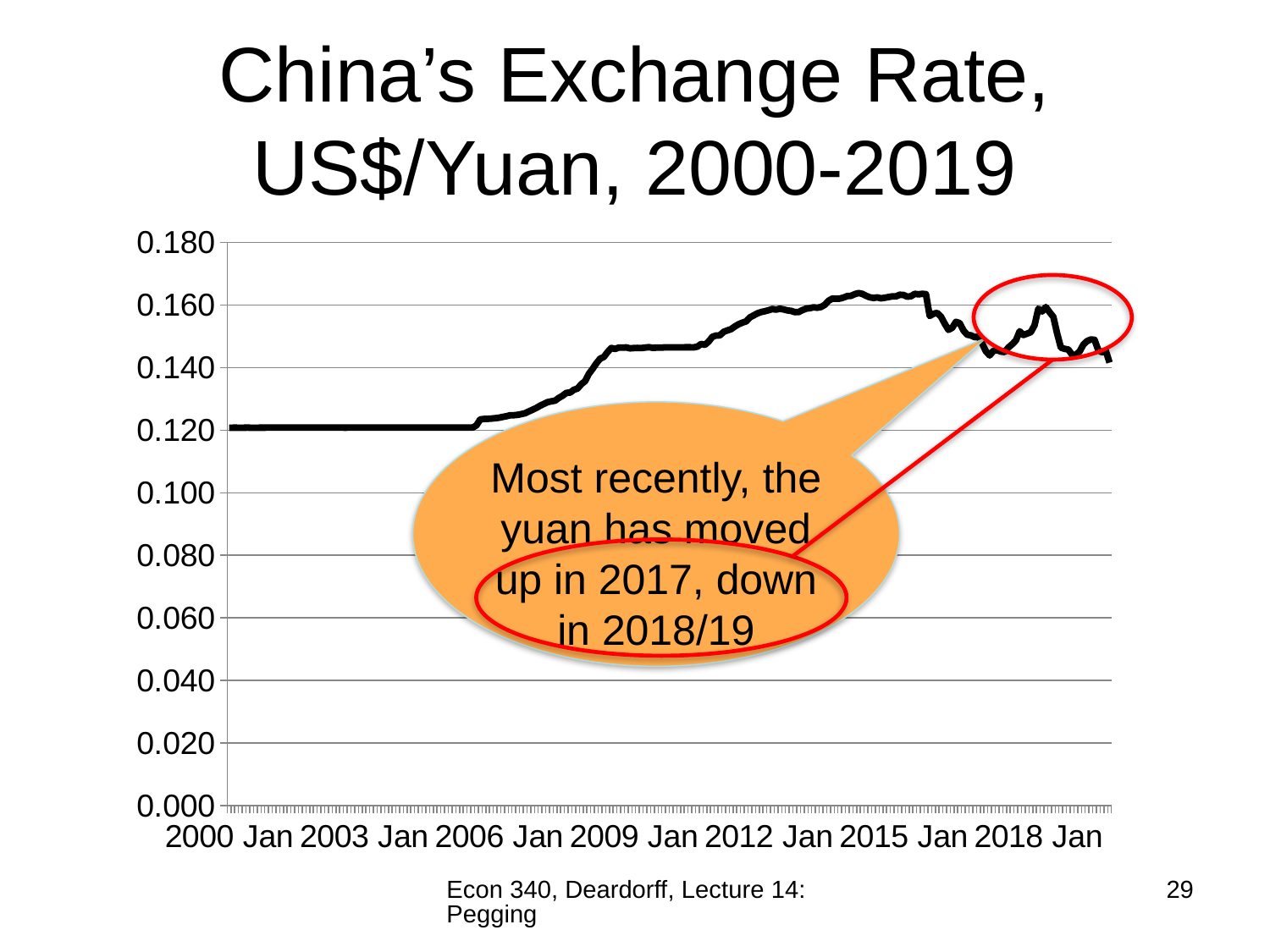
Is the exchange rate in 2006 Jan greater or less than 0.140? less What is the highest value shown on the y axis? 0.180 Is the exchange rate in 2009 Jan greater or less than 0.120? greater What kind of chart is shown on the slide? line chart Is the exchange rate in 2000 Jan greater or less than 0.140? less Does the exchange rate rise or fall overall from 2000 Jan to 2015 Jan? rise What is the title of the chart? China's Exchange Rate, US$/Yuan, 2000-2019 How many year labels are shown on the x axis? 7 Which is larger, the exchange rate in 2000 Jan or in 2015 Jan? 2015 Jan How many lines are plotted on the chart? 1